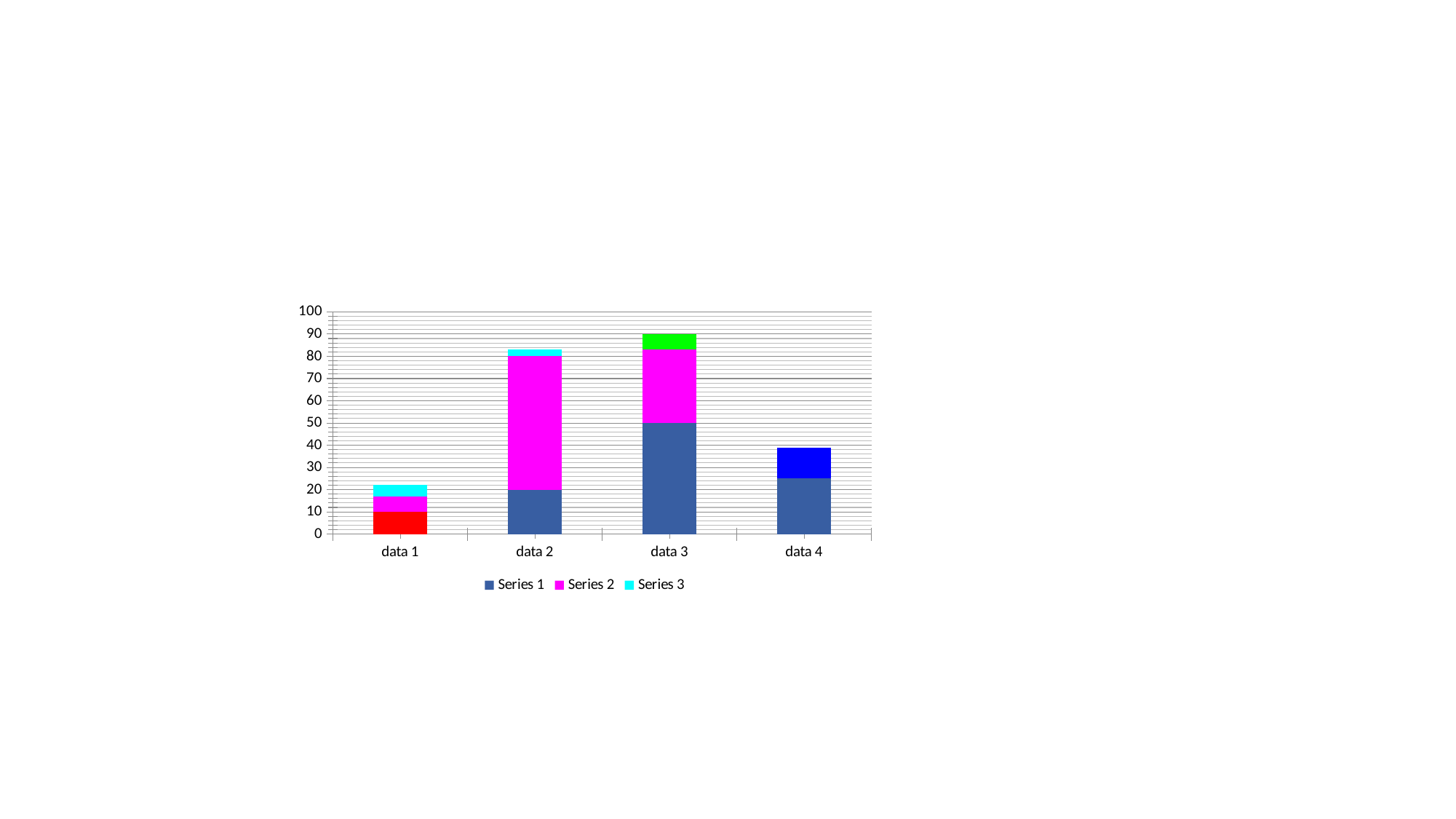
How many series does the legend list? 3 What are the three entries listed in the legend? Series 1, Series 2, Series 3 Which has the larger Series 1 value, data 3 or data 4? data 3 Which category has the shortest stacked bar overall? data 1 Is the total stacked value for data 3 greater or less than 80? greater What kind of chart is shown on the slide? stacked bar chart Which category has the tallest stacked bar overall? data 3 Which has the larger total stacked value, data 2 or data 4? data 2 Is the total stacked value for data 1 greater or less than 30? less Is the Series 1 value for data 3 greater or less than 40? greater How many categories are shown on the x axis? 4